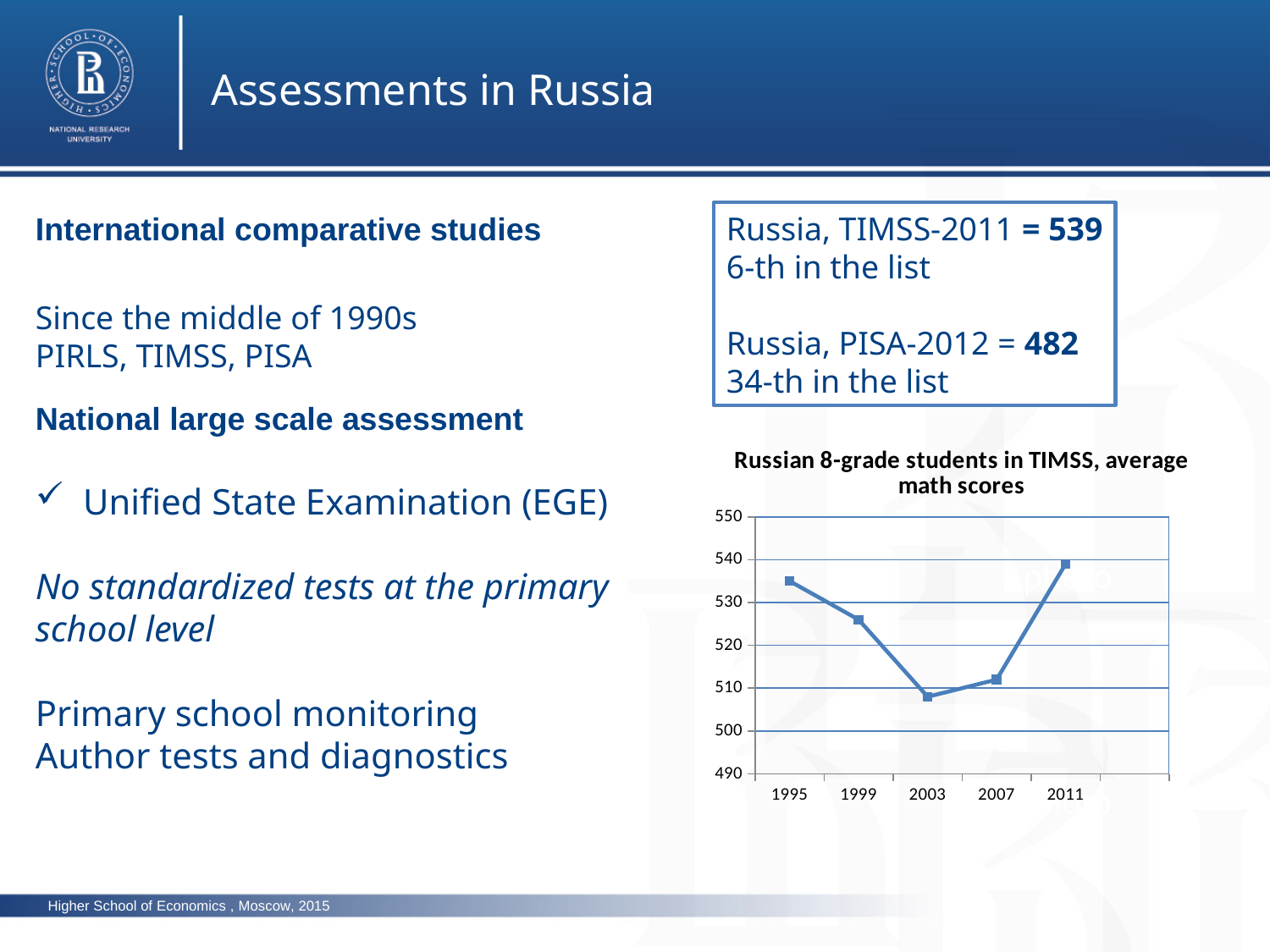
Is the average math score for 2003 greater or less than 520? less Which year has the higher average math score, 1995 or 1999? 1995 Is the average math score for 2007 greater or less than 520? less Which year has the highest average math score in the chart? 2011 Is the average math score for 2011 greater or less than 530? greater Do the average math scores rise or fall from 2003 to 2011? rise Which year has the lowest average math score in the chart? 2003 Do the average math scores rise or fall from 1995 to 2003? fall How many years are plotted on the x axis of the chart? 5 What kind of chart is shown on the slide? line chart What is the title of the chart on the slide? Russian 8-grade students in TIMSS, average math scores